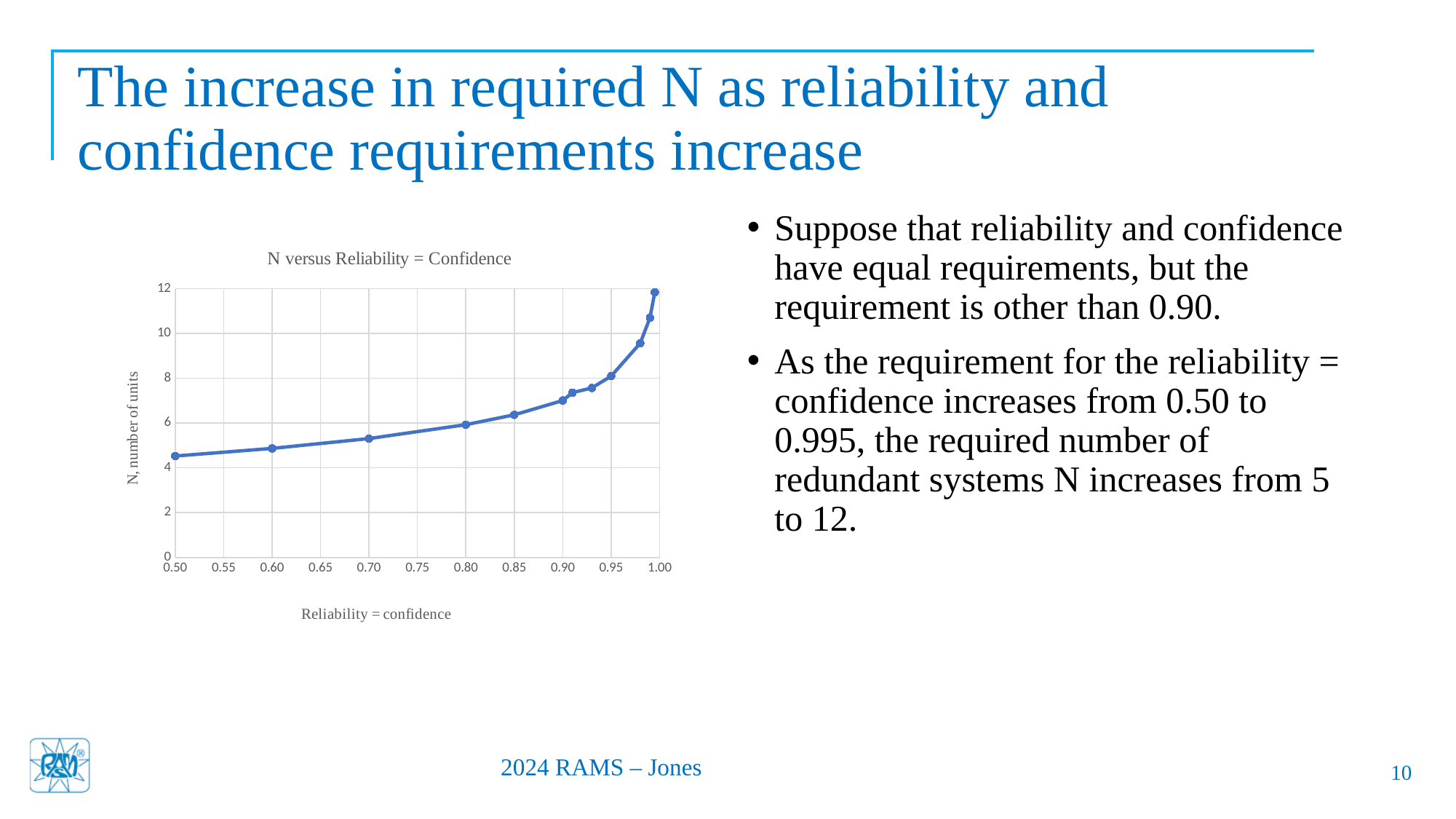
Is the value of N at Reliability = confidence 0.95 greater or less than 6? greater Is the value of N at Reliability = confidence 0.80 greater or less than 8? less What kind of chart is shown on the slide? line chart At which end of the x axis is N lowest, the left (0.50) or the right (near 1.00)? left (0.50) Is the value of N at Reliability = confidence 0.70 greater or less than 4? greater Does N rise or fall as Reliability = confidence increases along the x axis? rise Which has the larger N: Reliability = confidence 0.50 or 0.95? 0.95 Which has the smaller N: Reliability = confidence 0.60 or 0.90? 0.60 What is the label of the vertical axis of the chart? N, number of units What is the title of the chart? N versus Reliability = Confidence